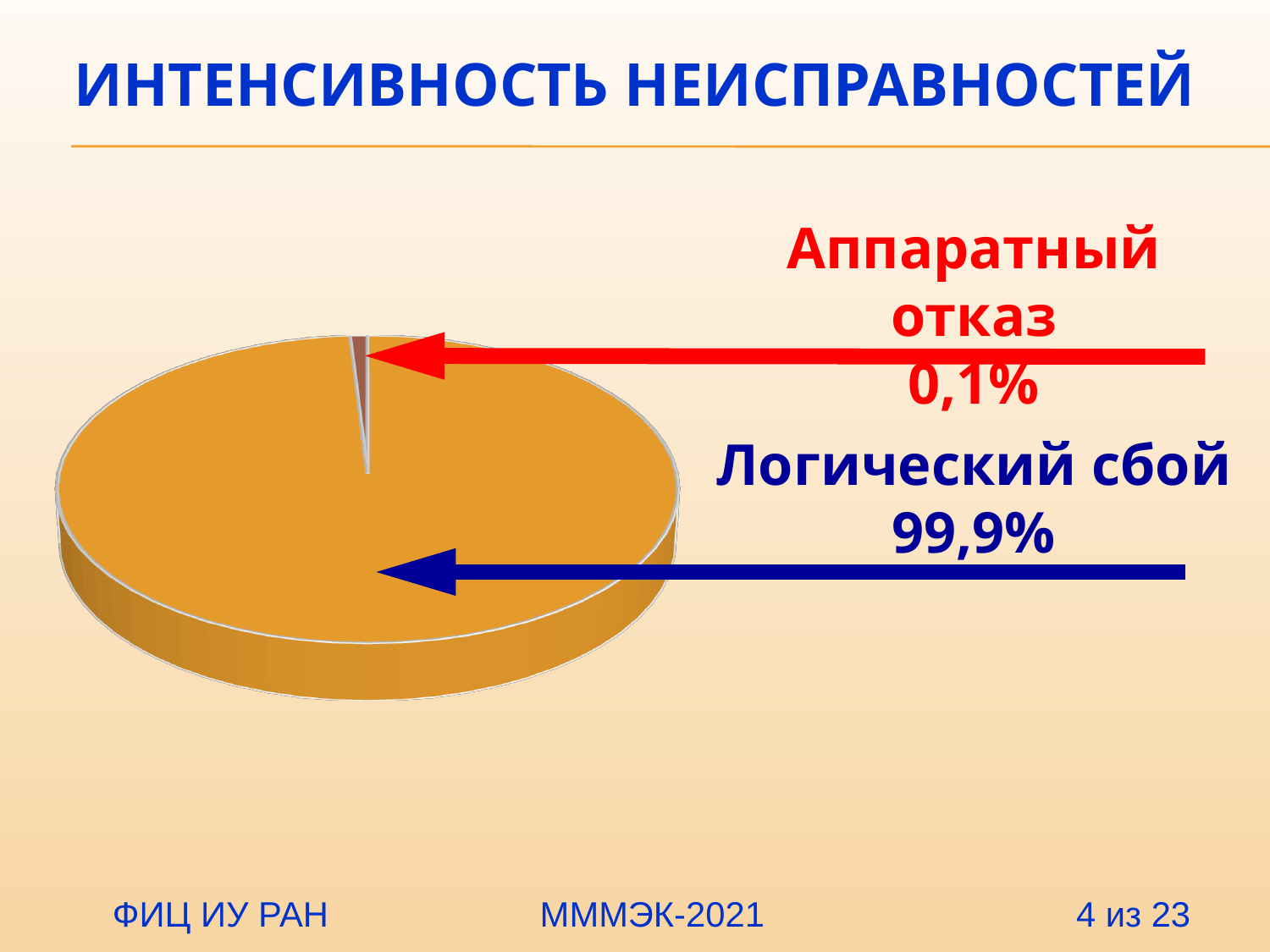
What share of the pie does "Аппаратный отказ" represent? 0,1% What is the title of the slide containing the pie chart? ИНТЕНСИВНОСТЬ НЕИСПРАВНОСТЕЙ What is the difference between the shares of "Логический сбой" and "Аппаратный отказ"? 99,8% Which slice of the pie is the smallest? Аппаратный отказ What share of the pie does "Логический сбой" represent? 99,9% Which is larger: the share of "Аппаратный отказ" or the share of "Логический сбой"? Логический сбой How many slices does the pie chart have? 2 What colour is the arrow pointing to the "Аппаратный отказ" slice? red Which slice of the pie is the largest? Логический сбой What kind of chart is shown on the slide? pie chart